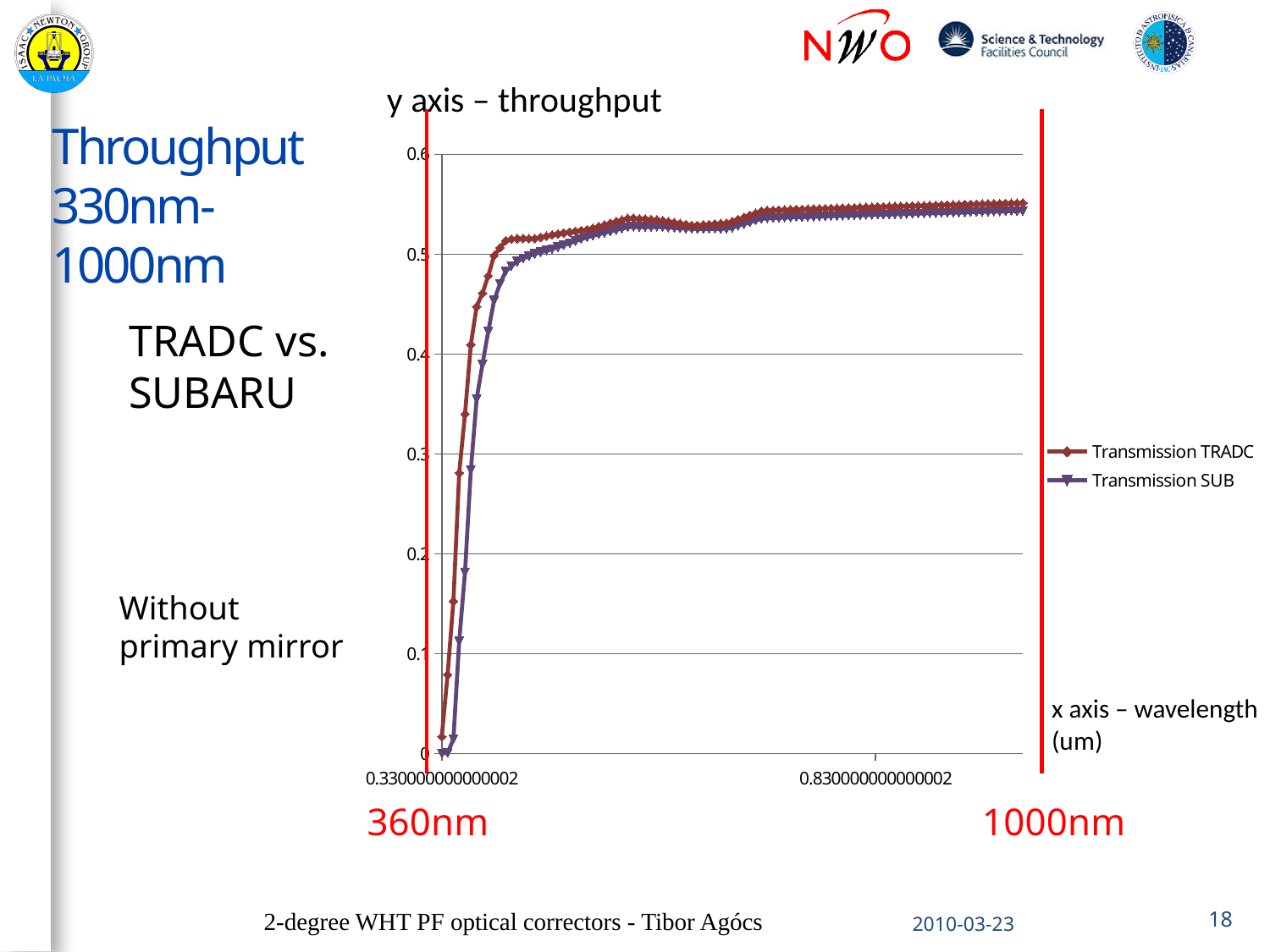
Do the throughput values rise or fall as wavelength increases along the x axis? rise Is the value for Transmission SUB at the x-axis tick 0.830000000000002 greater or less than 0.5? greater What are the two series named in the chart legend? Transmission TRADC and Transmission SUB Is the value for Transmission TRADC at the right end of the chart greater or less than 0.5? greater What kind of chart is shown on the slide? line chart Is the value for Transmission SUB at the x-axis tick 0.330000000000002 greater or less than 0.1? less In the steeply rising part of the curves near the left of the chart, which series has the higher throughput, Transmission TRADC or Transmission SUB? Transmission TRADC What quantity is plotted on the y axis of the chart? throughput How many series does the chart legend list? 2